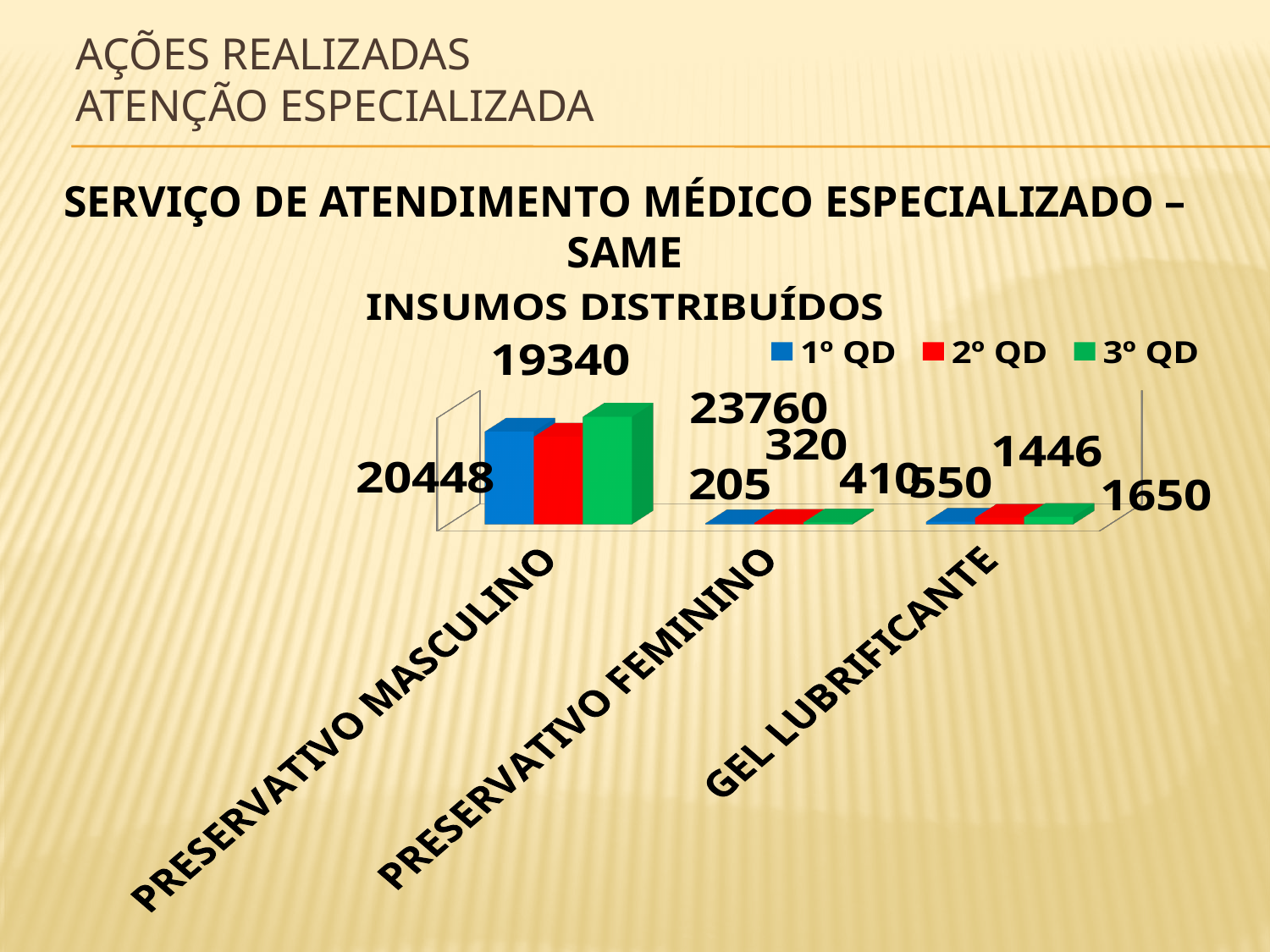
Which category has the highest value in the 3º QD series? PRESERVATIVO MASCULINO What type of chart is shown on the slide? bar chart How many categories are shown on the x axis? 3 Which category has the lowest value in the 1º QD series? PRESERVATIVO FEMININO How many series does the legend list? 3 Which is larger for PRESERVATIVO MASCULINO: the 1º QD value or the 2º QD value? 1º QD What is the value for PRESERVATIVO FEMININO in the 1º QD series? 205 What is the difference between the 3º QD and 1º QD values for GEL LUBRIFICANTE? 1100 What is the value for PRESERVATIVO MASCULINO in the 3º QD series? 23760 What is the value for GEL LUBRIFICANTE in the 2º QD series? 1446 Do the values for PRESERVATIVO FEMININO rise or fall from 1º QD to 3º QD? rise What is the title of the chart? INSUMOS DISTRIBUÍDOS